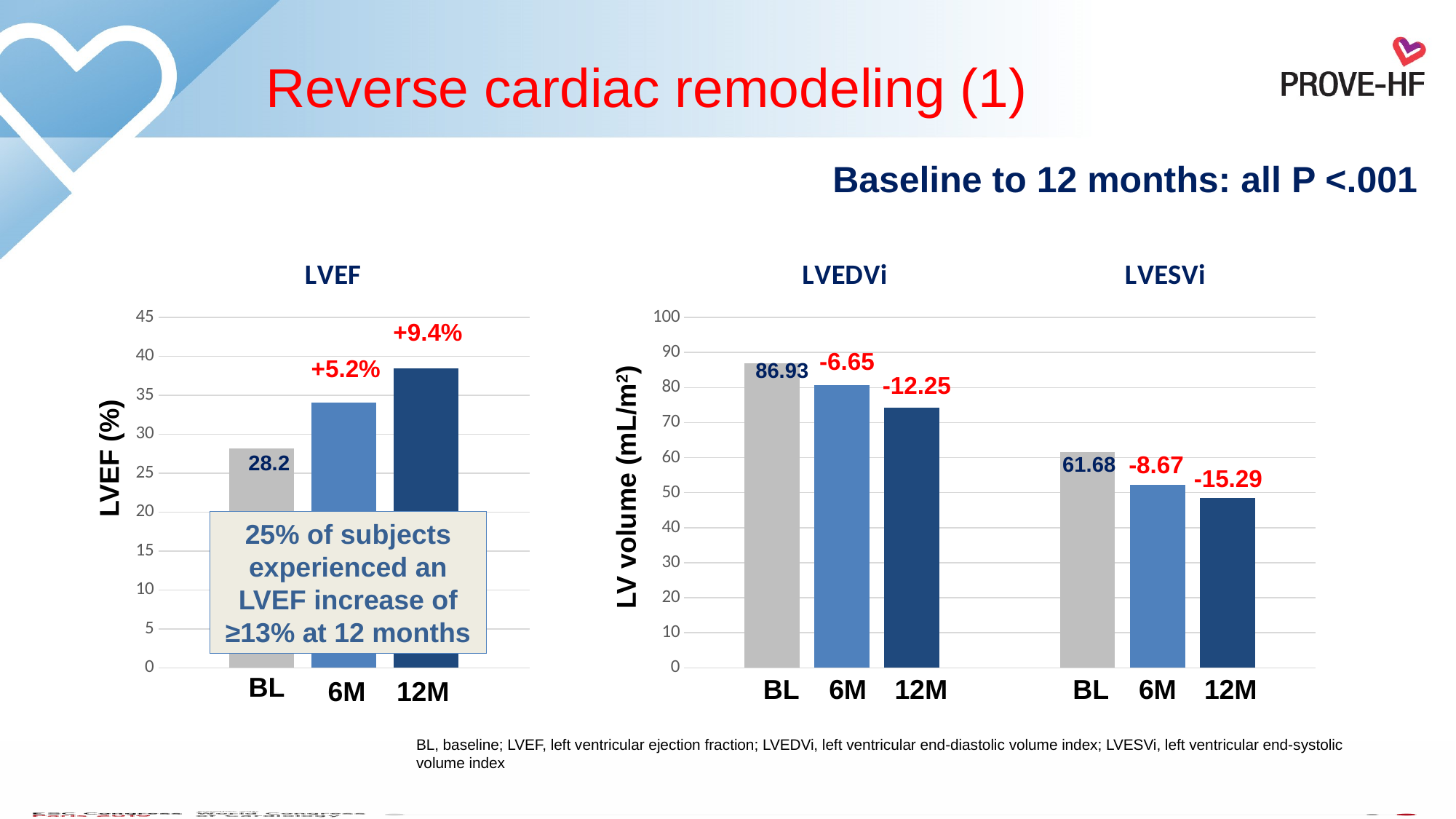
In the LVEF chart, do the LVEF values rise or fall from BL to 12M? rise In the LV volume chart, what change label is shown above the LVEDVi 6M bar? -6.65 In the LVEF chart, which time point has the highest LVEF? 12M In the LVEF chart, what change label is shown above the 6M bar? +5.2% In the LV volume chart, what is the LVEDVi value at baseline (BL)? 86.93 In the LVEF chart, is the LVEF value at 12M greater or less than 35? greater What kind of chart is the LV volume chart? bar chart In the LV volume chart, which LVESVi time point has the lowest value? 12M In the LV volume chart, what is the LVESVi value at baseline (BL)? 61.68 In the LVEF chart, what change label is shown above the 12M bar? +9.4% In the LV volume chart, what change label is shown above the LVESVi 12M bar? -15.29 In the LVEF chart, what is the LVEF value at baseline (BL)? 28.2